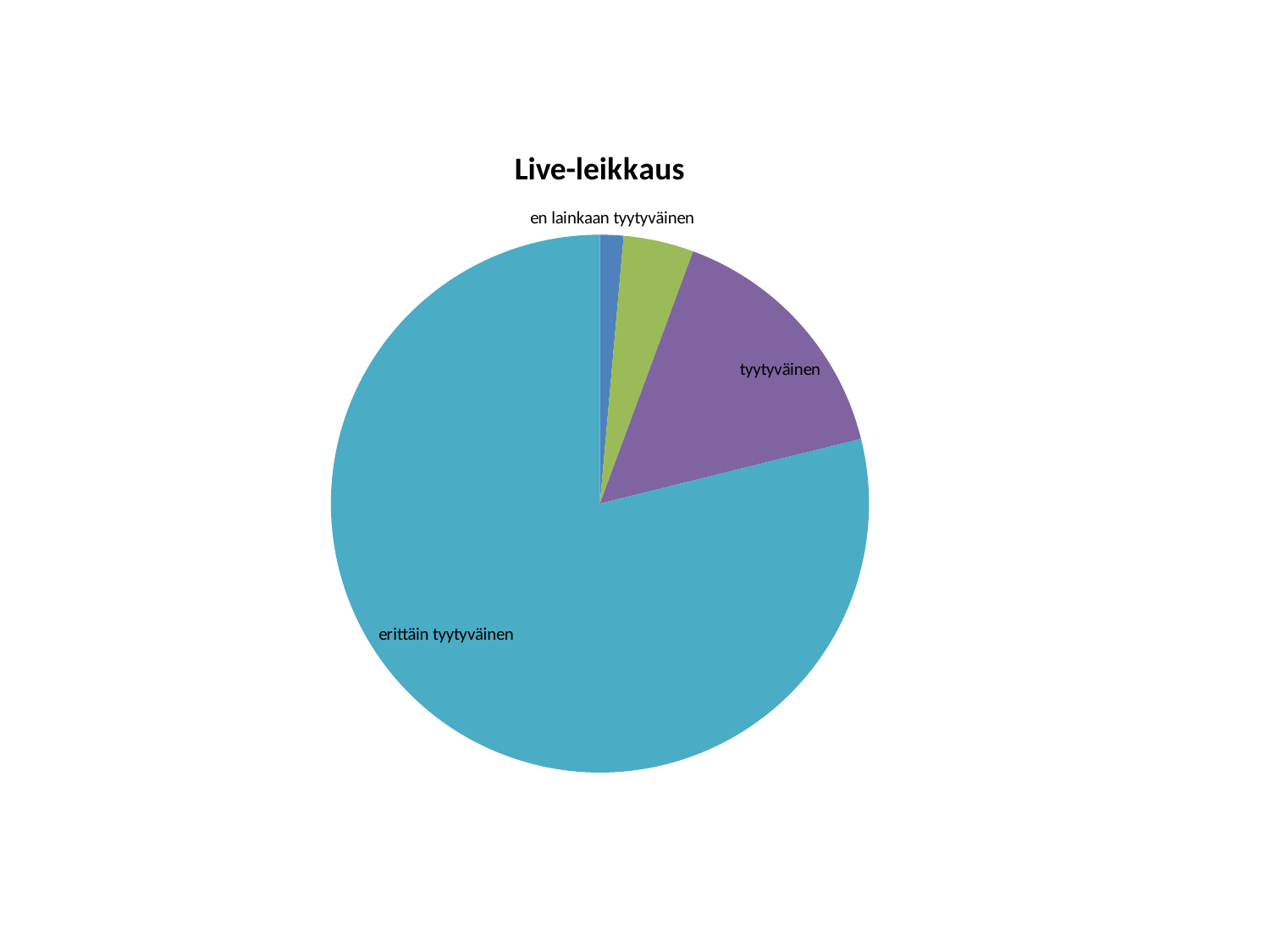
What colour is the "erittäin tyytyväinen" slice? teal blue What is the title of the chart? Live-leikkaus How many slices does the pie chart have? 4 Does the "erittäin tyytyväinen" slice take up more or less than half of the pie? more Which slice is larger, "tyytyväinen" or "en lainkaan tyytyväinen"? tyytyväinen Which labelled category has the smallest slice of the pie? en lainkaan tyytyväinen Which slice is larger, "erittäin tyytyväinen" or "tyytyväinen"? erittäin tyytyväinen What kind of chart is shown on the slide? pie chart Which category has the largest slice of the pie? erittäin tyytyväinen How many slices of the pie have a text label? 3